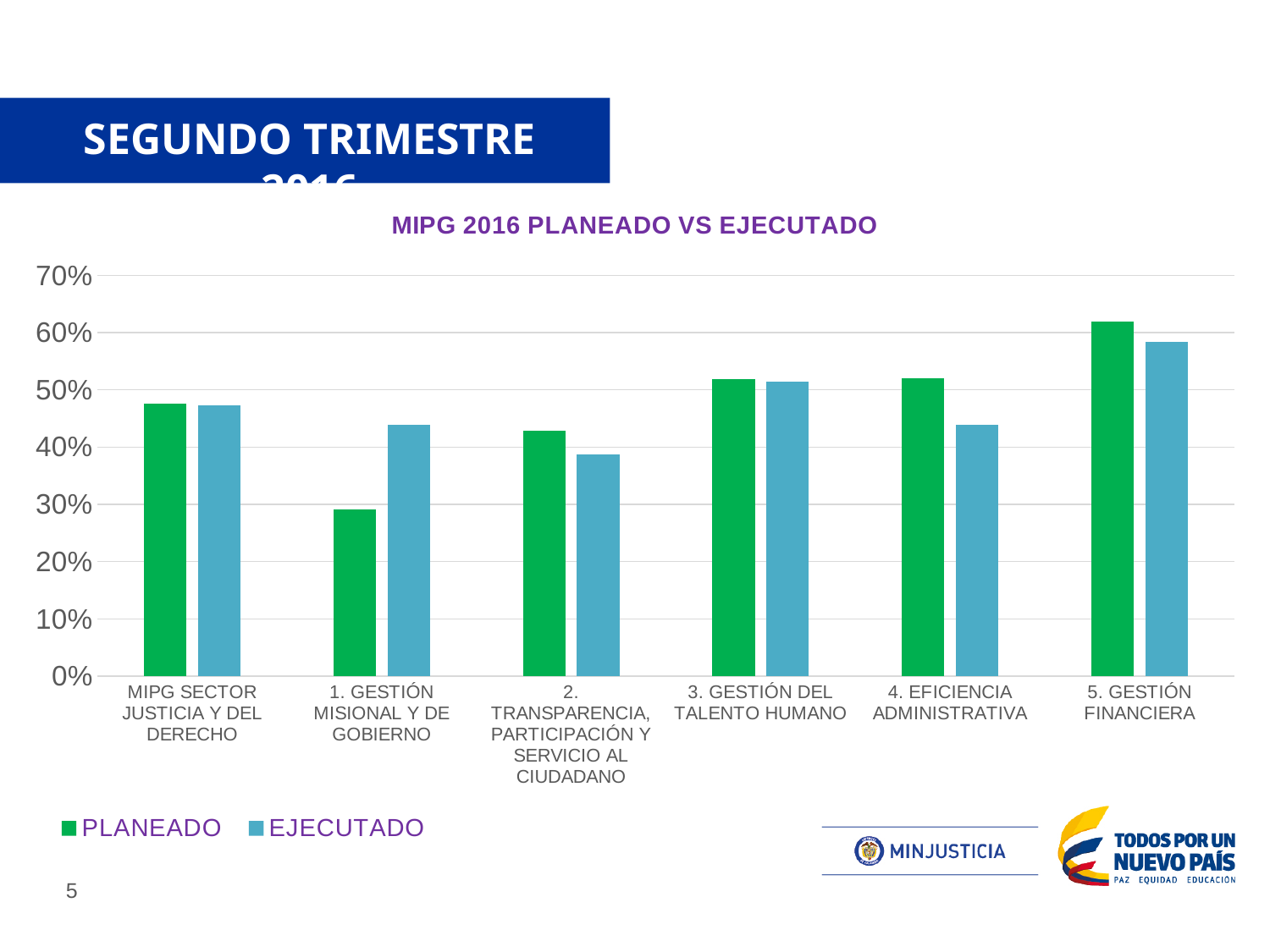
Is the PLANEADO value for 1. GESTIÓN MISIONAL Y DE GOBIERNO greater or less than 40%? less Which category has the lowest PLANEADO value? 1. GESTIÓN MISIONAL Y DE GOBIERNO Which category has the lowest EJECUTADO value? 2. TRANSPARENCIA, PARTICIPACIÓN Y SERVICIO AL CIUDADANO Which category has the highest PLANEADO value? 5. GESTIÓN FINANCIERA How many categories are shown on the x axis? 6 For 4. EFICIENCIA ADMINISTRATIVA, which is larger, PLANEADO or EJECUTADO? PLANEADO What is the title of the chart? MIPG 2016 PLANEADO VS EJECUTADO How many series does the legend list? 2 Is the EJECUTADO value for 4. EFICIENCIA ADMINISTRATIVA greater or less than 40%? greater For 1. GESTIÓN MISIONAL Y DE GOBIERNO, which is larger, PLANEADO or EJECUTADO? EJECUTADO What type of chart is shown on the slide? Bar chart Is the PLANEADO value for 5. GESTIÓN FINANCIERA greater or less than 60%? greater